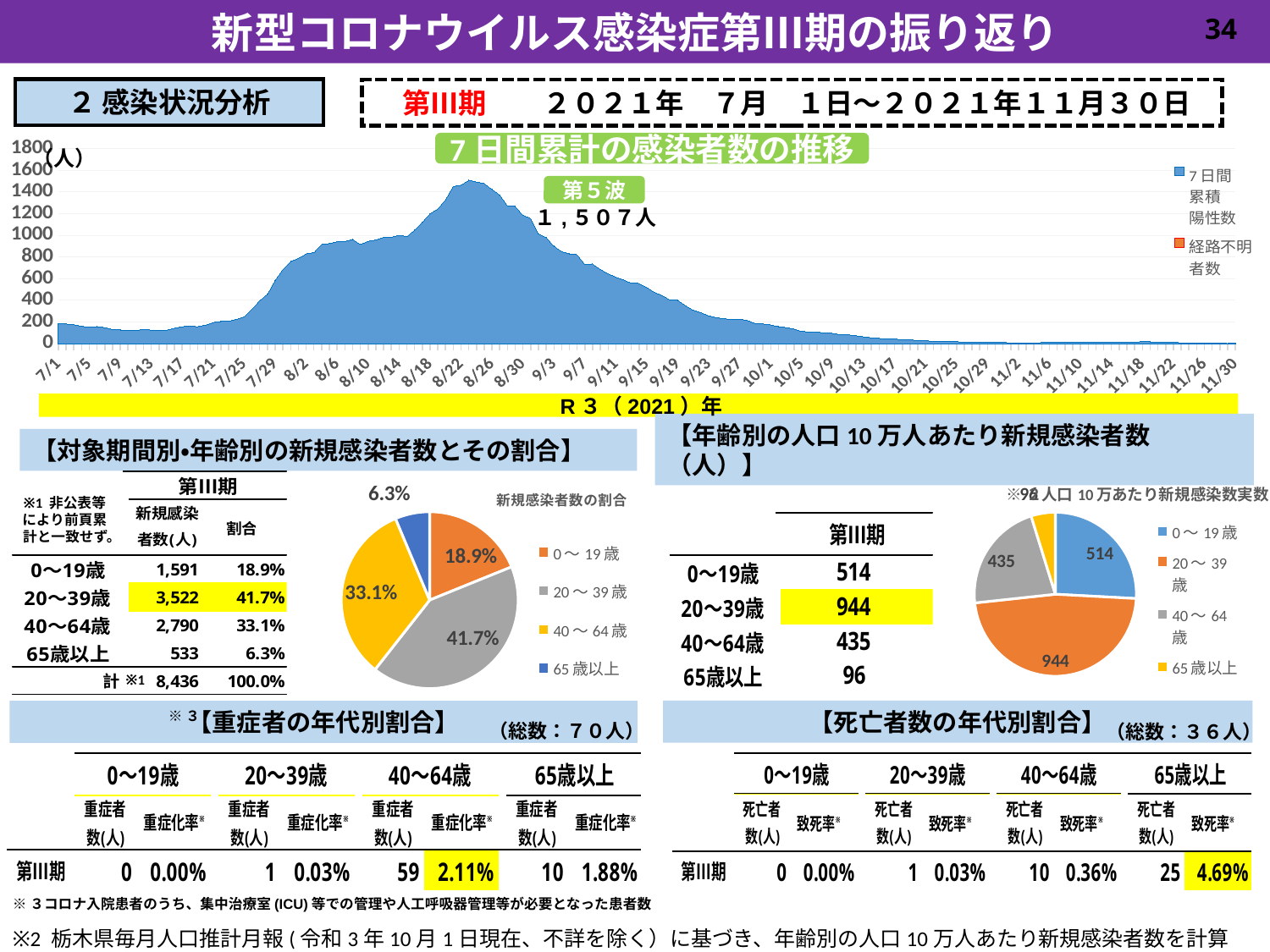
How many series does the legend of the top chart (7日間累計の感染者数の推移) list? 2 What kind of chart is the top chart titled 7日間累計の感染者数の推移? area chart In the top chart (7日間累計の感染者数の推移), is the value on 11/30 greater or less than 200? less In the top chart (7日間累計の感染者数の推移), what is the peak value labeled for 第5波? 1,507人 How many slices does the pie chart 新規感染者数の割合 have? 4 In the pie chart 新規感染者数の割合, which age group has the smallest slice? 65歳以上 In the top chart (7日間累計の感染者数の推移), do the values rise or fall from 8/26 to 11/30? fall In the pie chart 新規感染者数の割合, what is the difference between the 20～39歳 share and the 40～64歳 share? 8.6 percentage points In the pie chart 年齢別の人口10万人あたり新規感染者数, which is larger, 0～19歳 or 40～64歳? 0～19歳 In the pie chart 新規感染者数の割合, what share does 20～39歳 have? 41.7% In the pie chart 年齢別の人口10万人あたり新規感染者数, what is the difference between the 20～39歳 value and the 0～19歳 value? 430 In the pie chart 年齢別の人口10万人あたり新規感染者数, what is the value for 20～39歳? 944